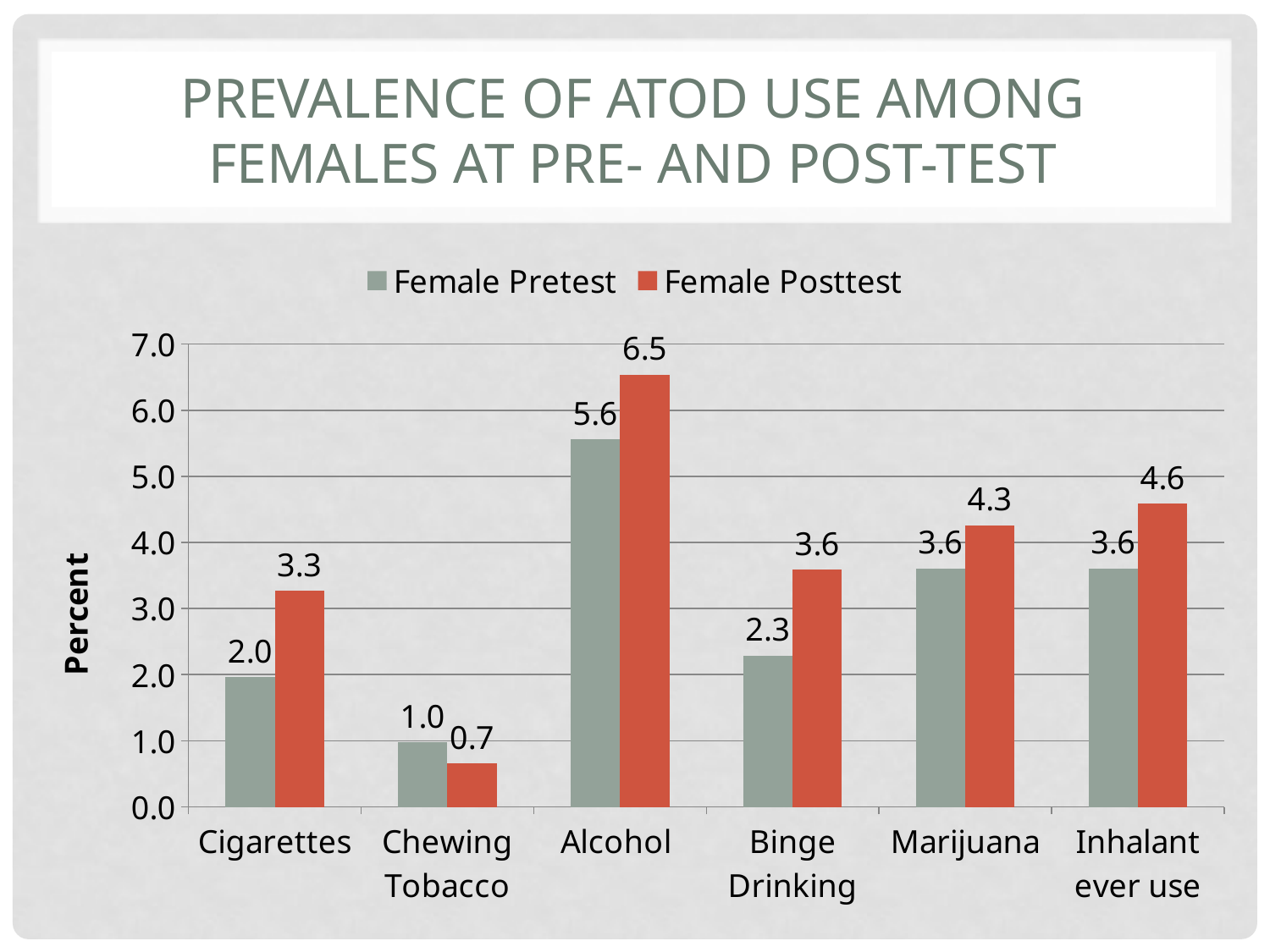
What is the Female Posttest value for Chewing Tobacco? 0.7 What is the difference between the Female Posttest and Female Pretest values for Cigarettes? 1.3 Which is larger for Inhalant ever use, the Female Pretest value or the Female Posttest value? Female Posttest Which is larger for Chewing Tobacco, the Female Pretest value or the Female Posttest value? Female Pretest What is the Female Posttest value for Alcohol? 6.5 Which category has the lowest Female Posttest value? Chewing Tobacco What is the label on the vertical axis? Percent What kind of chart is shown on the slide? Bar chart How many series does the legend list? 2 How many categories are shown on the x axis? 6 Which category has the highest Female Pretest value? Alcohol What is the Female Pretest value for Binge Drinking? 2.3